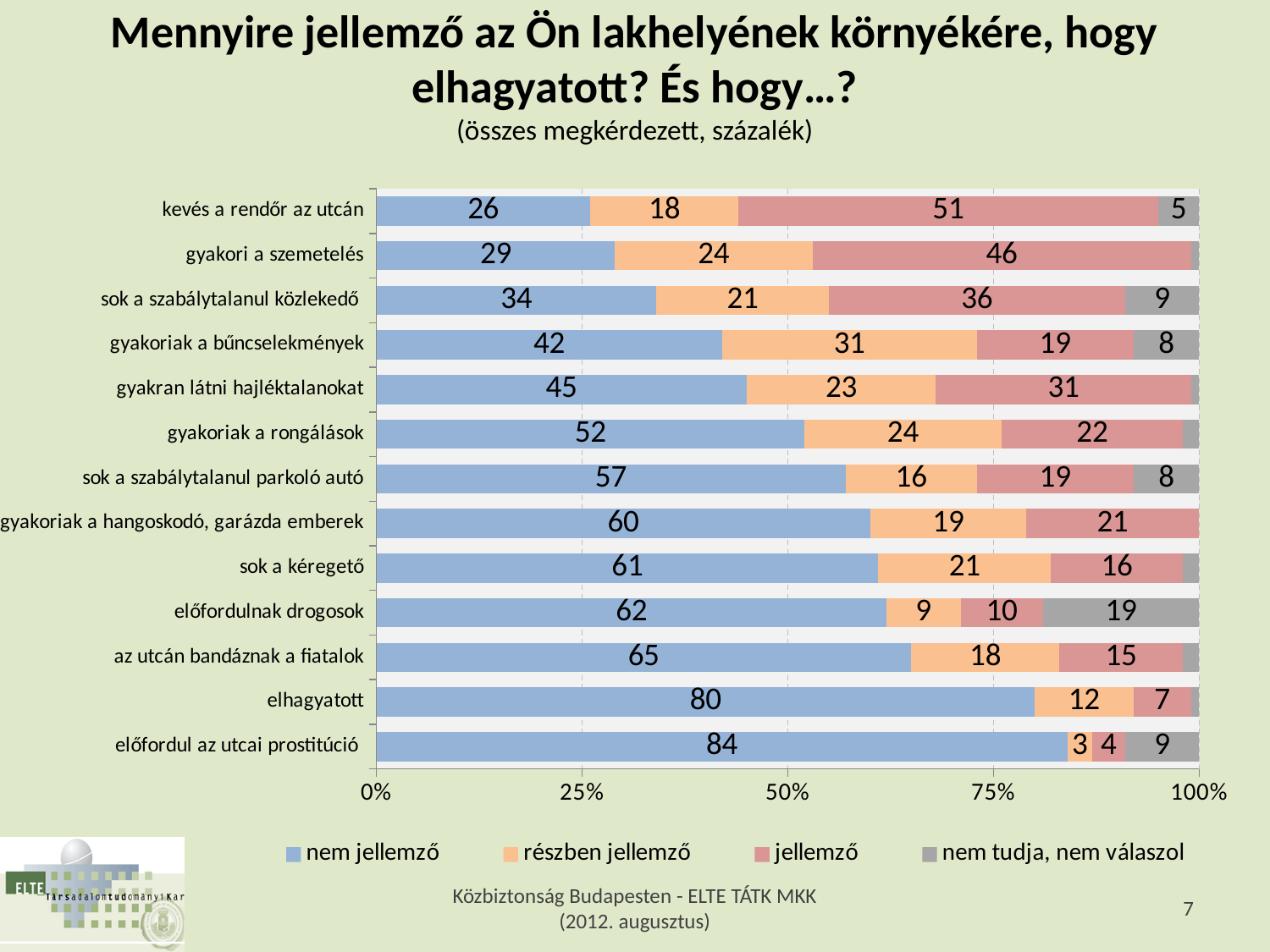
What kind of chart is shown on the slide? stacked bar chart What is the value of "jellemző" for "kevés a rendőr az utcán"? 51 Is the "nem jellemző" value for "sok a kéregető" greater or less than 50%? greater What is the value of "nem jellemző" for "elhagyatott"? 80 Which has the larger "jellemző" value: "gyakori a szemetelés" or "sok a szabálytalanul közlekedő"? gyakori a szemetelés How many categories are shown on the chart? 13 Which category has the highest "nem jellemző" value? előfordul az utcai prostitúció What is the difference between the "nem jellemző" values for "előfordul az utcai prostitúció" and "elhagyatott"? 4 Which category has the lowest "nem jellemző" value? kevés a rendőr az utcán What is the value of "nem tudja, nem válaszol" for "előfordulnak drogosok"? 19 How many series does the legend list? 4 Which legend entry is shown in blue? nem jellemző